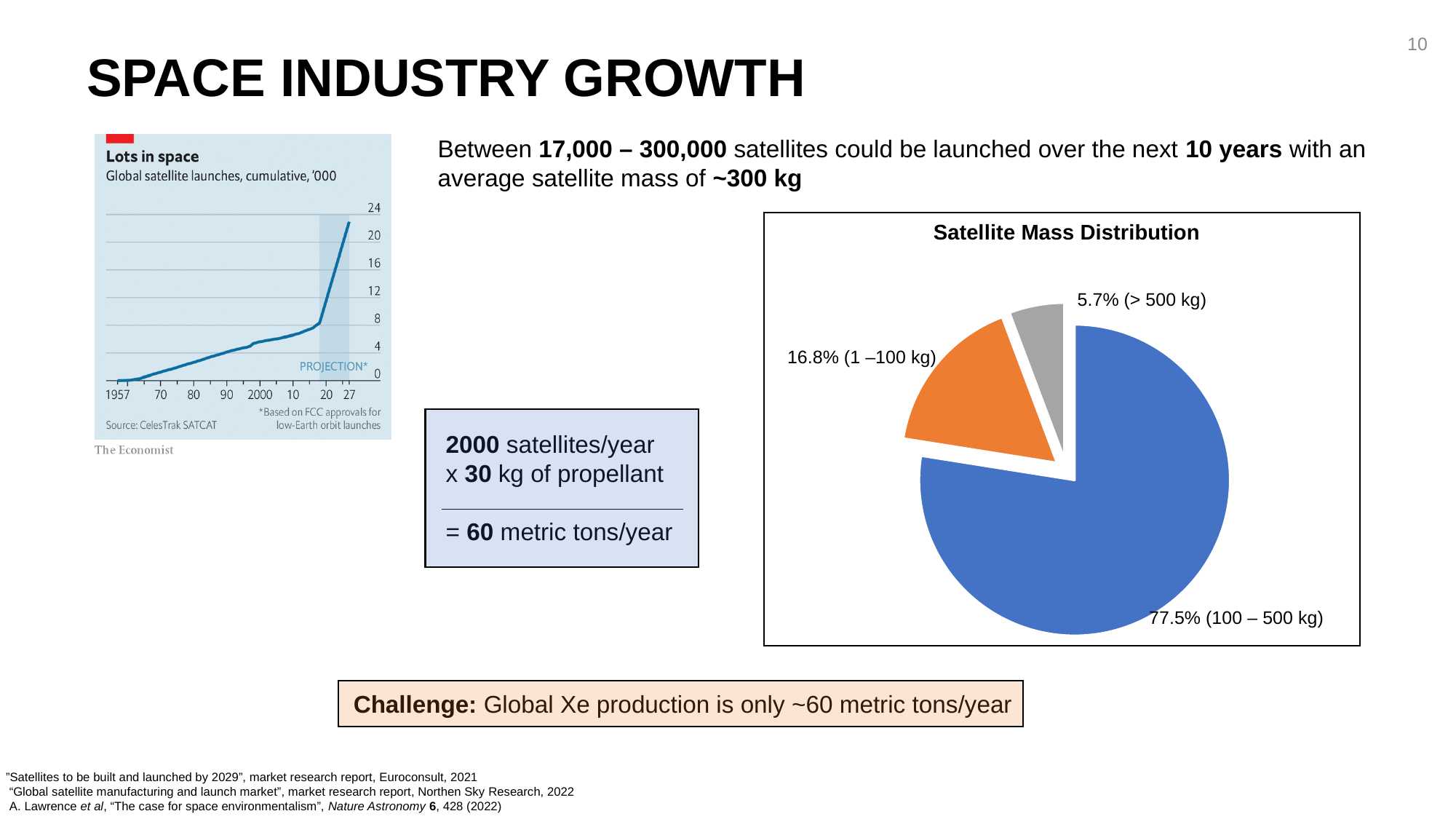
In the Satellite Mass Distribution chart, what share of satellites falls in the 100 – 500 kg range? 77.5% What type of chart is the 'Lots in space' chart on the left of the slide? Line chart In the Satellite Mass Distribution chart, what is the difference in percentage points between the 100 – 500 kg slice and the 1 – 100 kg slice? 60.7 percentage points In the Satellite Mass Distribution chart, how many slices does the pie have? 3 What type of chart is the Satellite Mass Distribution chart? Pie chart In the 'Lots in space' chart, is the projected cumulative value at 2027 greater or less than 20 (thousand)? greater In the Satellite Mass Distribution chart, which mass range has the largest slice? 100 – 500 kg In the 'Lots in space' chart, do cumulative global satellite launches rise or fall from 1957 to 2027? Rise In the Satellite Mass Distribution chart, which slice is larger: 1 – 100 kg or > 500 kg? 1 – 100 kg In the Satellite Mass Distribution chart, what share of satellites is heavier than 500 kg? 5.7% In the Satellite Mass Distribution chart, what share of satellites falls in the 1 – 100 kg range? 16.8% In the Satellite Mass Distribution chart, which mass range has the smallest slice? > 500 kg